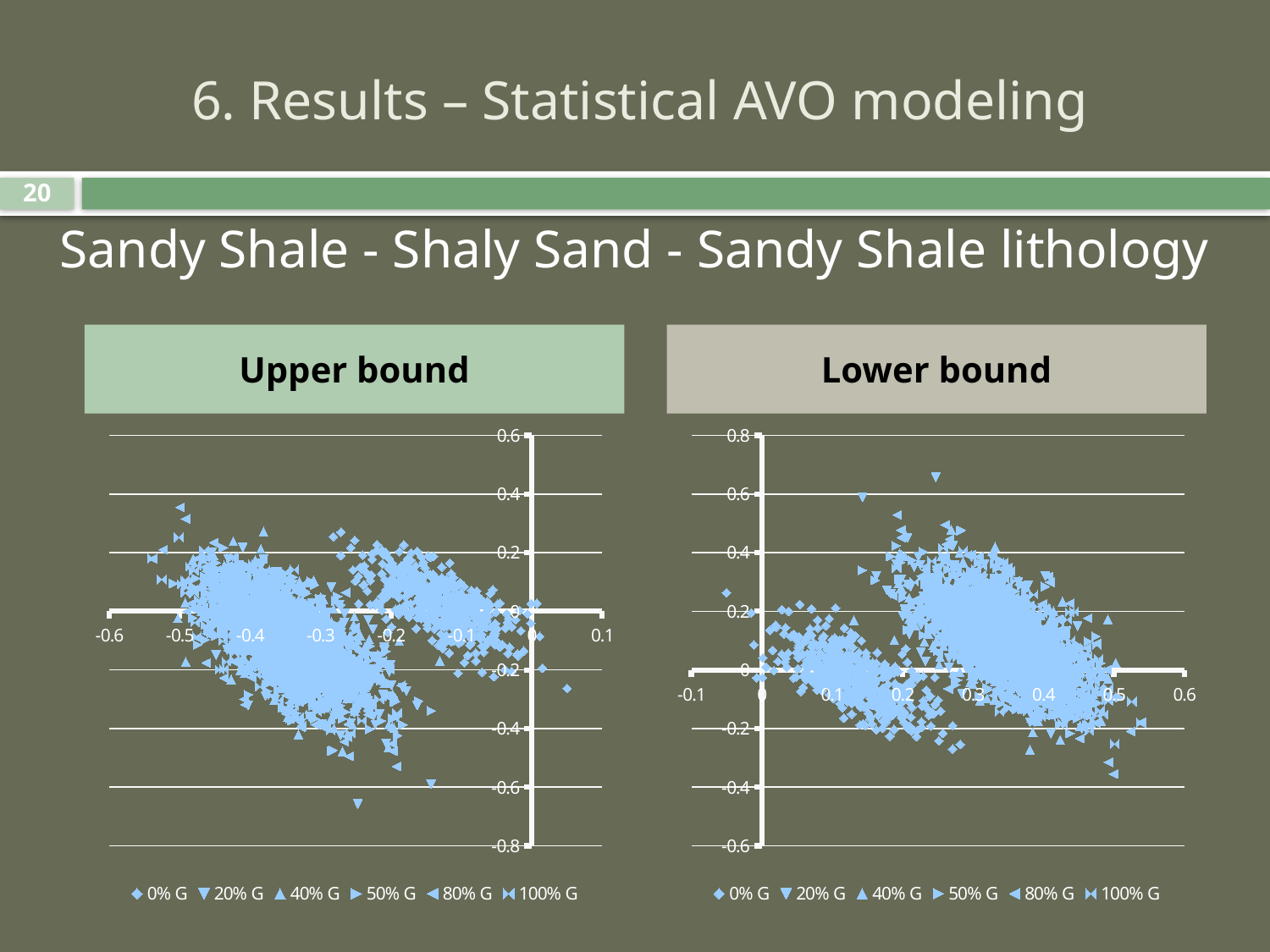
What kind of chart is the Upper bound chart? scatter chart How many series does the legend of the Upper bound chart list? 6 In the Upper bound chart, do the plotted points generally rise or fall as the x value increases? fall How many series does the legend of the Lower bound chart list? 6 What is the highest tick value shown on the vertical axis of the Lower bound chart? 0.8 What kind of chart is the Lower bound chart? scatter chart Which series is listed first in the legend of the Upper bound chart? 0% G In the Lower bound chart, do the plotted points generally rise or fall as the x value increases? fall